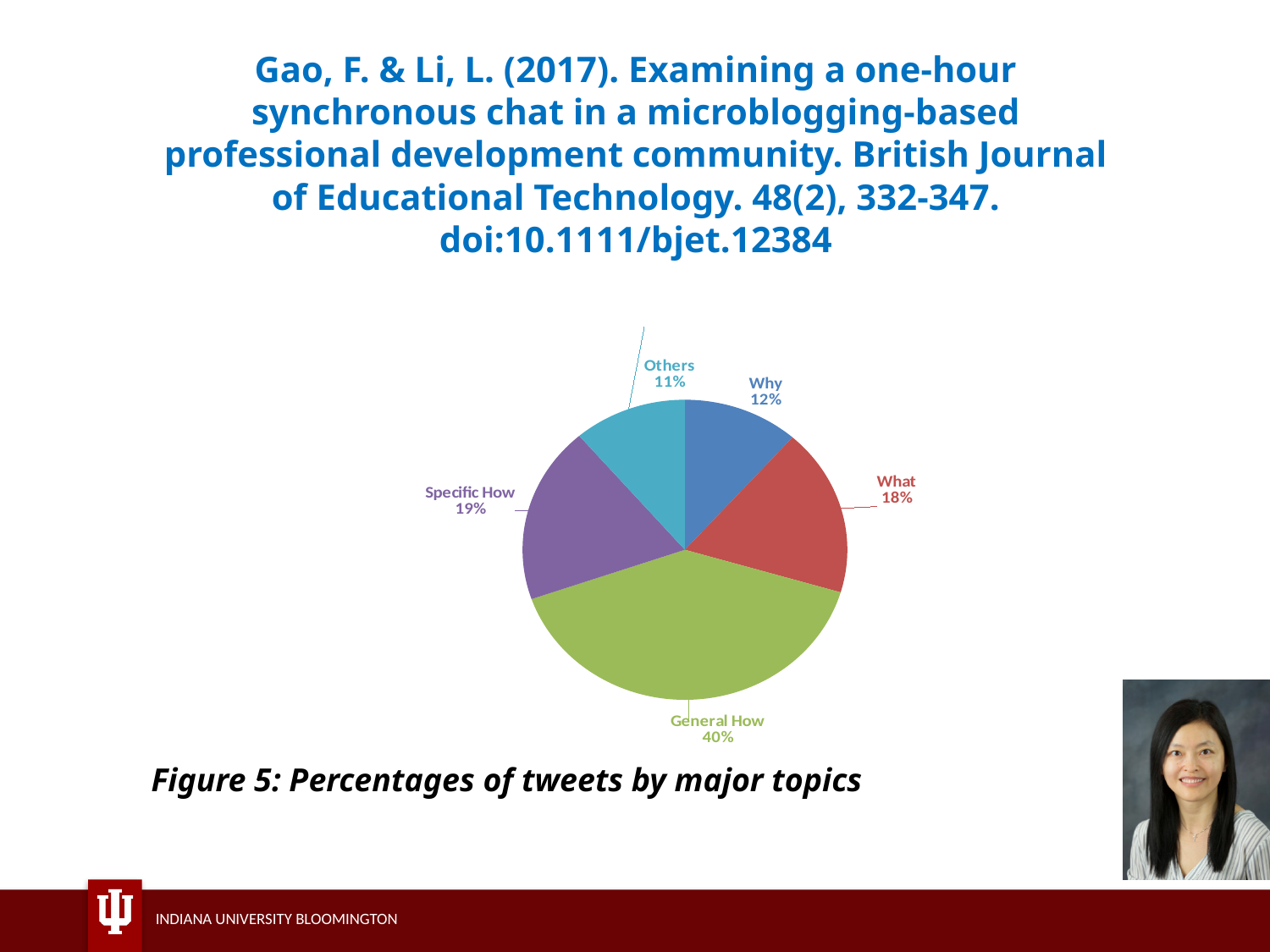
What is the difference in percentage points between General How and Specific How? 21 What percentage of tweets is labelled for What? 18% Which has a larger share of tweets, What or Why? What What percentage of tweets is labelled for Specific How? 19% What kind of chart is shown on the slide? pie chart Which topic has the smallest share of tweets? Others What percentage of tweets is labelled for Why? 12% What percentage of tweets is labelled for General How? 40% What is the figure caption below the pie chart? Figure 5: Percentages of tweets by major topics Which topic has the largest share of tweets? General How How many topic slices does the pie chart have? 5 What percentage of tweets is labelled for Others? 11%